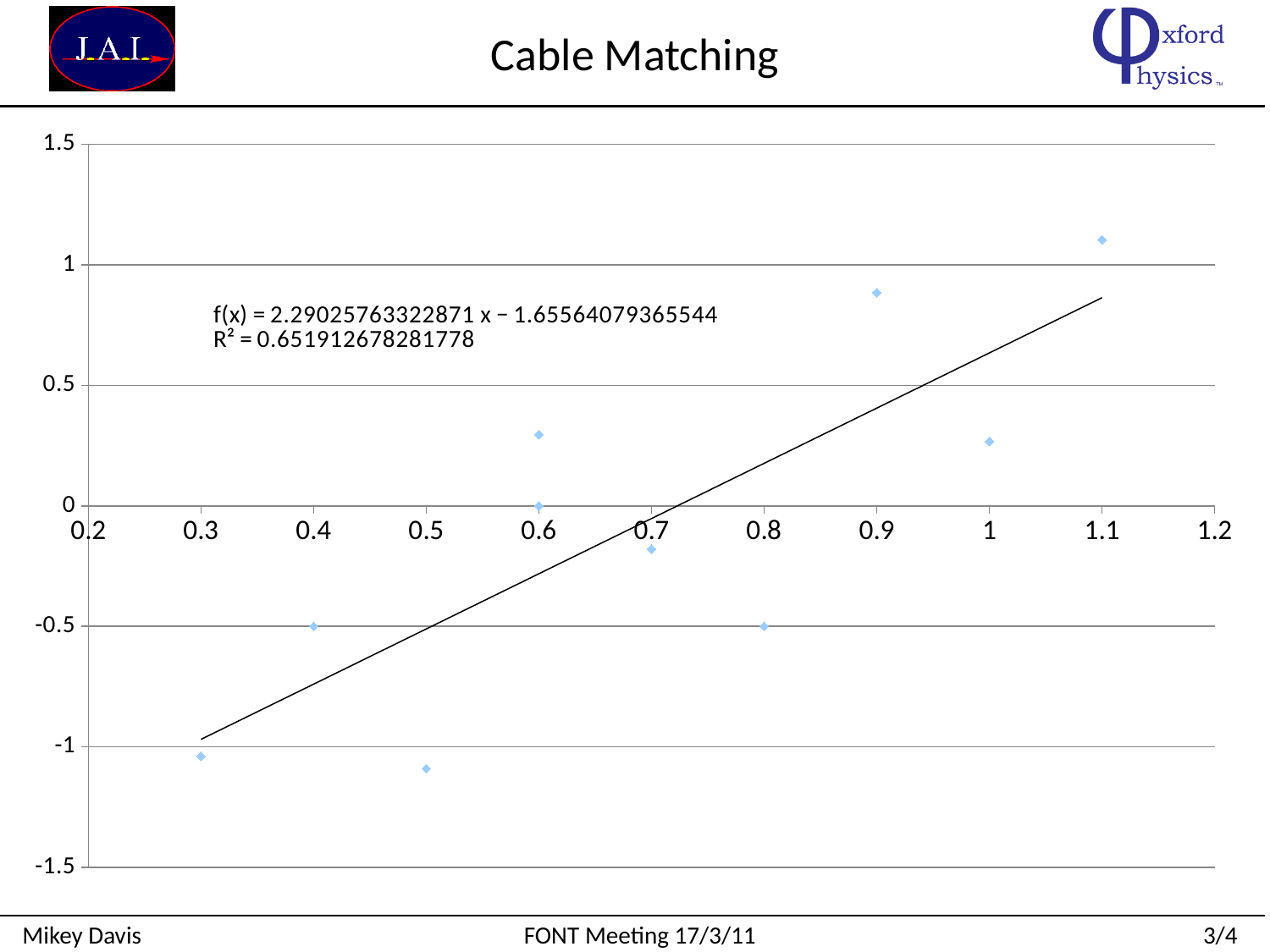
What is the title of the chart on the slide? Cable Matching What is the R² value printed on the chart? 0.651912678281778 Does the fitted trend line rise or fall as x increases? rise Is the y value of the data point at x = 0.5 greater or less than -1? less Which data point has the larger y value, the one at x = 0.9 or the one at x = 1? x = 0.9 What kind of chart is shown on the slide? scatter chart Is the y value of the data point at x = 0.9 greater or less than 0.5? greater At which x value does the highest data point occur? 1.1 Is the y value of the data point at x = 1.1 greater or less than 1? greater